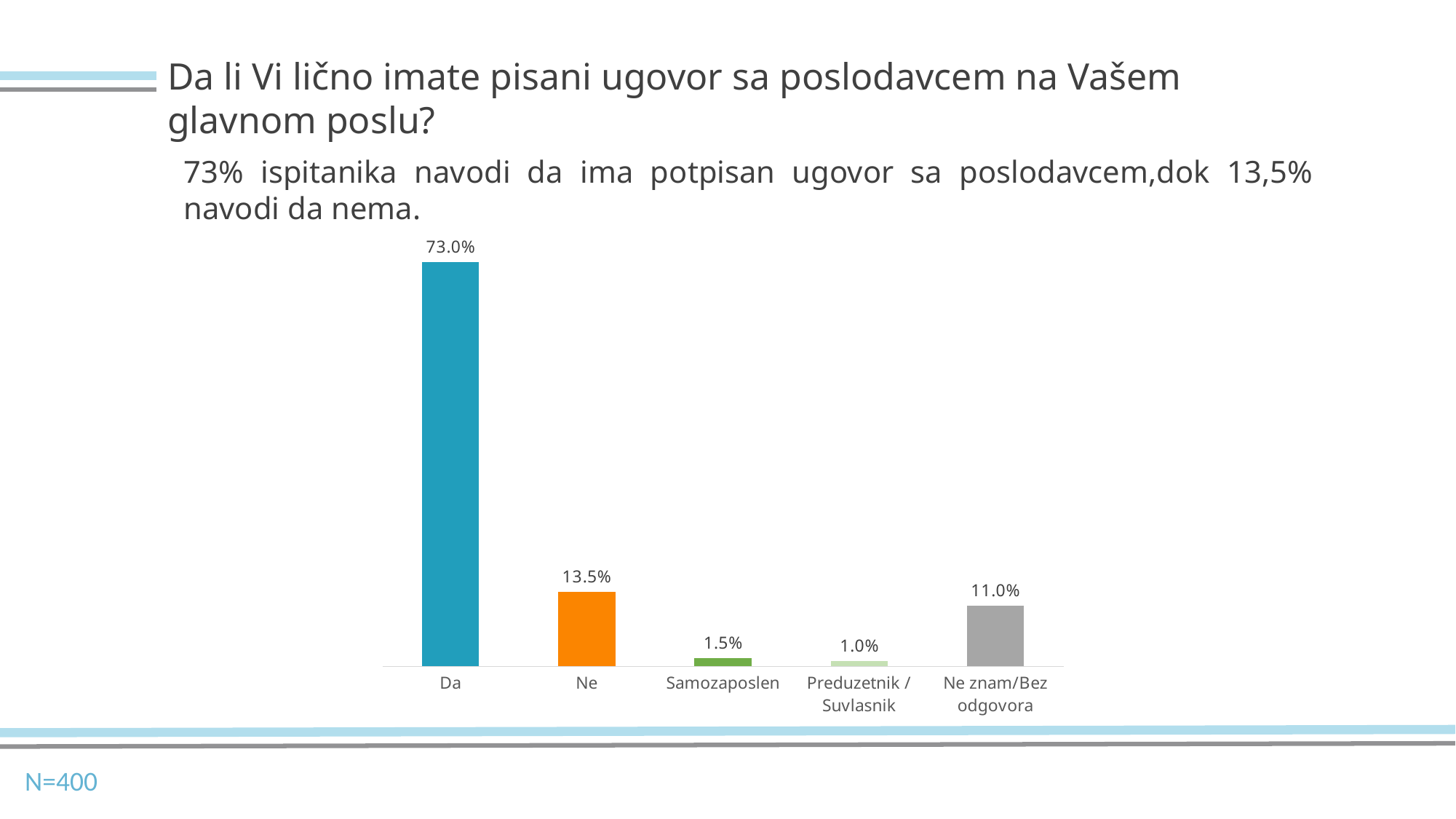
What is the value for "Ne znam/Bez odgovora"? 11.0% What kind of chart is shown on the slide? Bar chart Which category has the lowest value? Preduzetnik / Suvlasnik What is the value for "Ne"? 13.5% What colour is the bar for "Ne"? Orange What is the value for "Preduzetnik / Suvlasnik"? 1.0% Which category has the highest value? Da What is the value for "Samozaposlen"? 1.5% How many categories are shown in the chart? 5 What is the value for "Da"? 73.0% What is the difference between the values for "Da" and "Ne"? 59.5% Which is larger, the value for "Ne" or the value for "Ne znam/Bez odgovora"? Ne